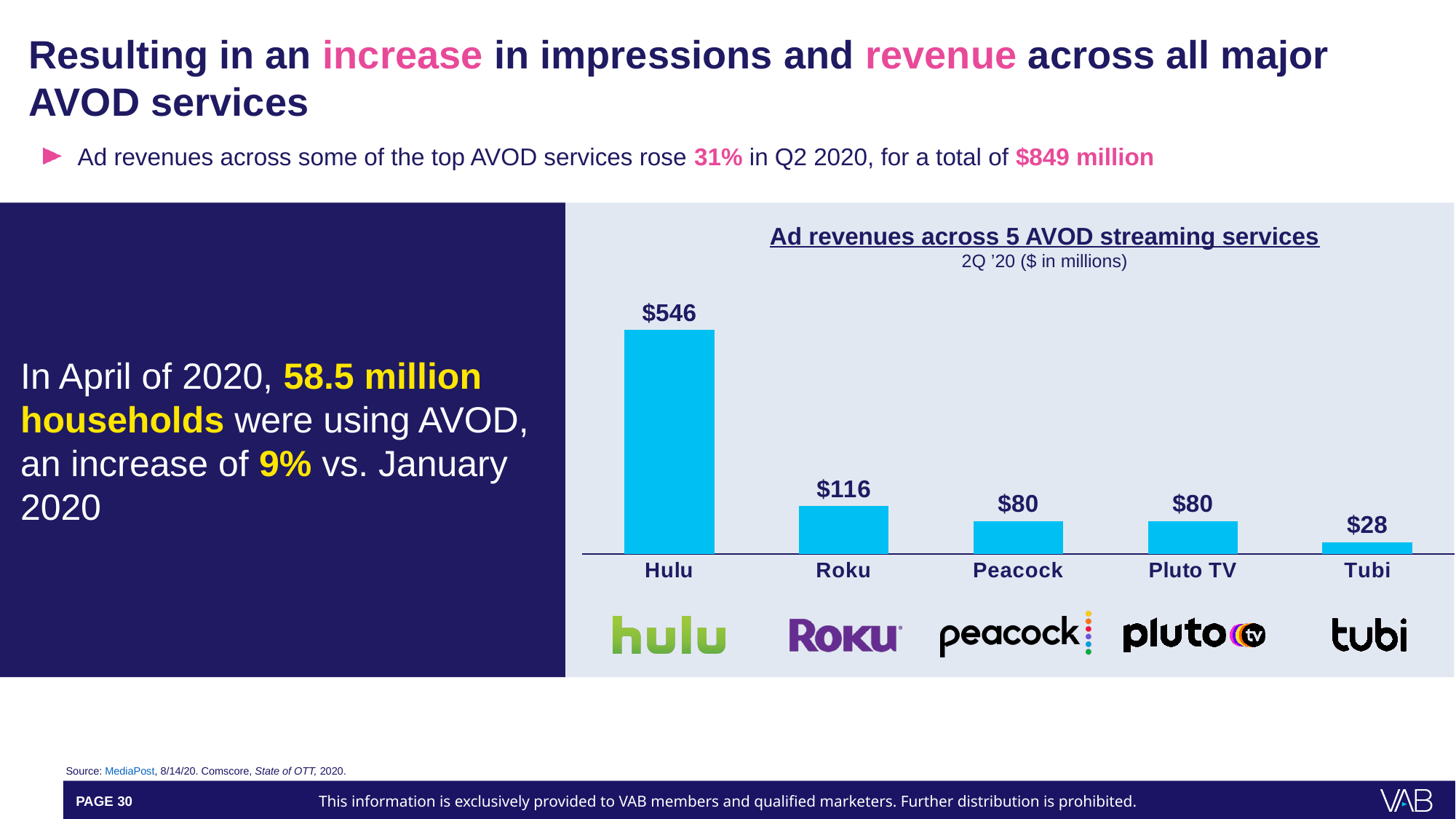
Which service has the highest ad revenue in the chart? Hulu Which has a larger ad revenue value, Roku or Peacock? Roku What is the ad revenue value shown for Hulu? $546 What is the difference between Hulu's and Roku's ad revenue values? $430 What unit is stated in the chart subtitle? $ in millions What is the ad revenue value shown for Tubi? $28 What is the title of the chart? Ad revenues across 5 AVOD streaming services What kind of chart is used to show ad revenues across the AVOD services? Bar chart Which service has the lowest ad revenue in the chart? Tubi What is the difference between Roku's and Tubi's ad revenue values? $88 How many services are shown in the chart? 5 What is the ad revenue value shown for Roku? $116